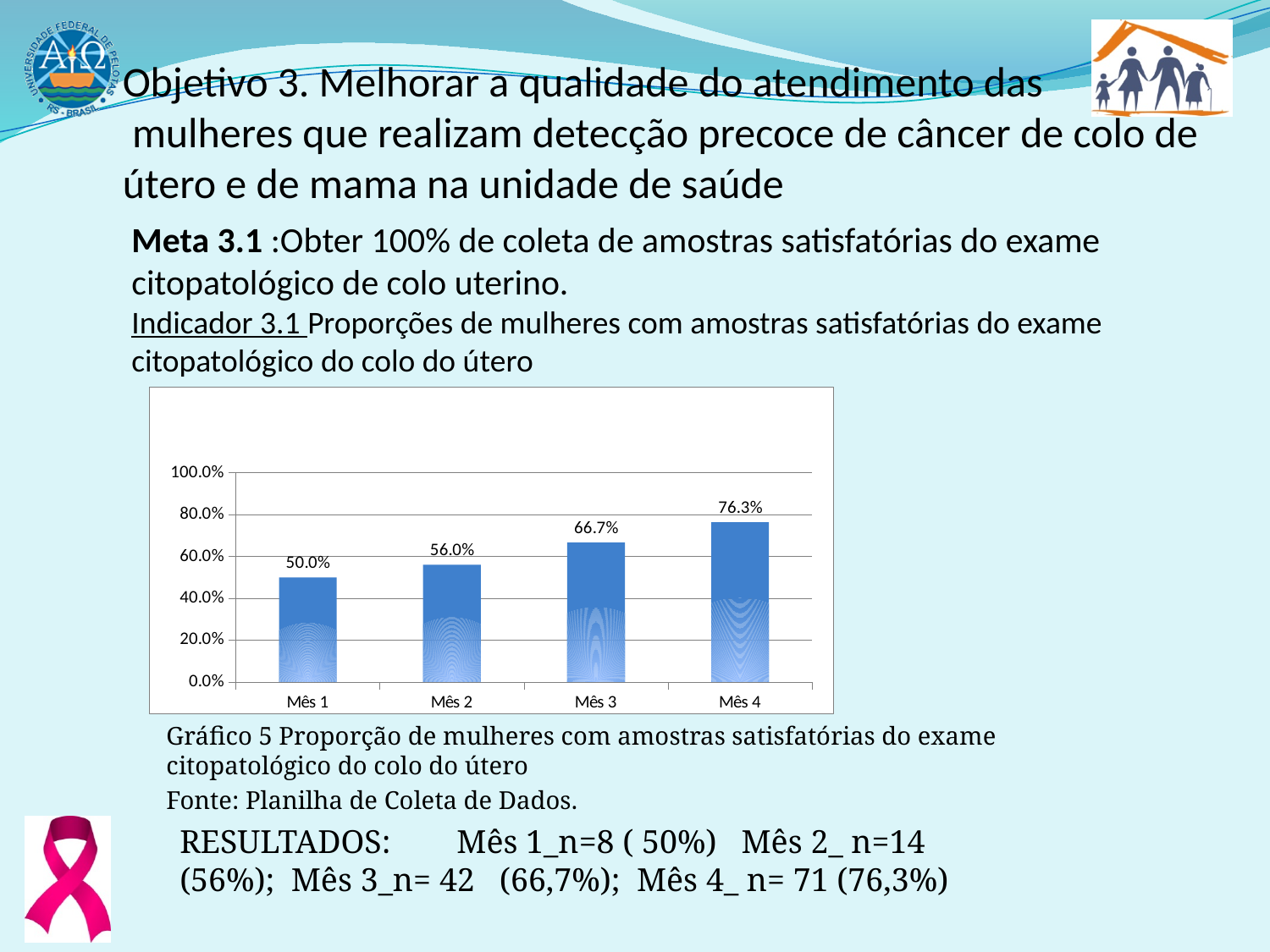
What is the difference between the values for Mês 4 and Mês 1? 26.3% How many months are shown on the x axis? 4 What is the value for Mês 2? 56.0% What is the difference between the values for Mês 3 and Mês 2? 10.7% Which month has the lowest value? Mês 1 What is the value for Mês 4? 76.3% Which month has the highest value? Mês 4 Is the value for Mês 4 greater or less than 80.0%? less What is the value for Mês 1? 50.0% What is the value for Mês 3? 66.7% What kind of chart is shown? bar chart Which is larger, the value for Mês 2 or the value for Mês 3? Mês 3